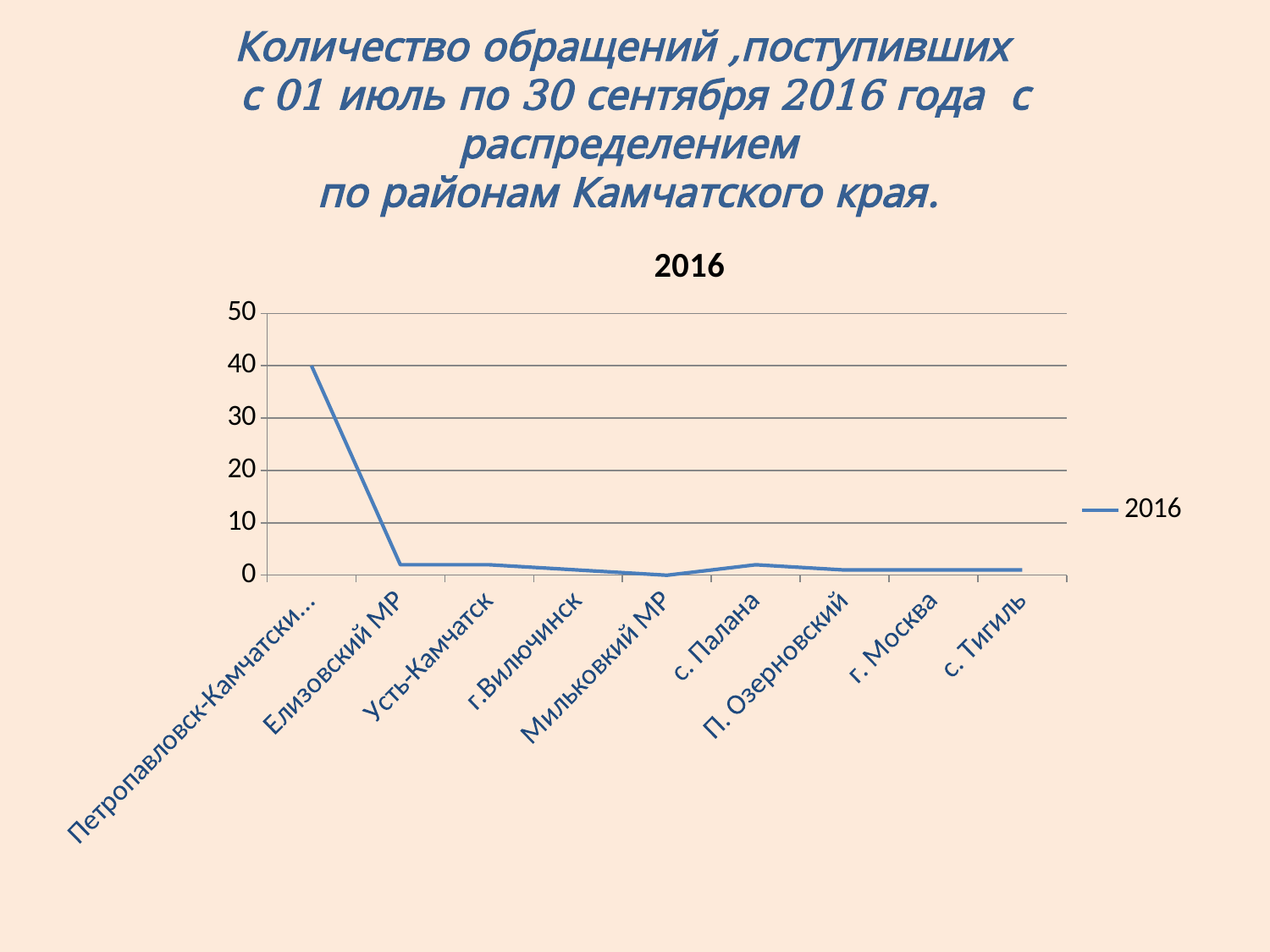
Is the value for Петропавловск-Камчатски... greater or less than 30? greater What is the value for Петропавловск-Камчатски...? 40 What is the title shown above the chart? 2016 How many series does the legend list? 1 Which is larger, the value for Петропавловск-Камчатски... or the value for Елизовский МР? Петропавловск-Камчатски... Is the value for Елизовский МР greater or less than 10? less How many categories are plotted along the x axis? 9 Which category has the highest value? Петропавловск-Камчатски... Which category has the lowest value? Мильковкий МР What kind of chart is shown on the slide? line chart What is the value for Мильковкий МР? 0 Do the values generally rise or fall from left to right along the x axis? fall